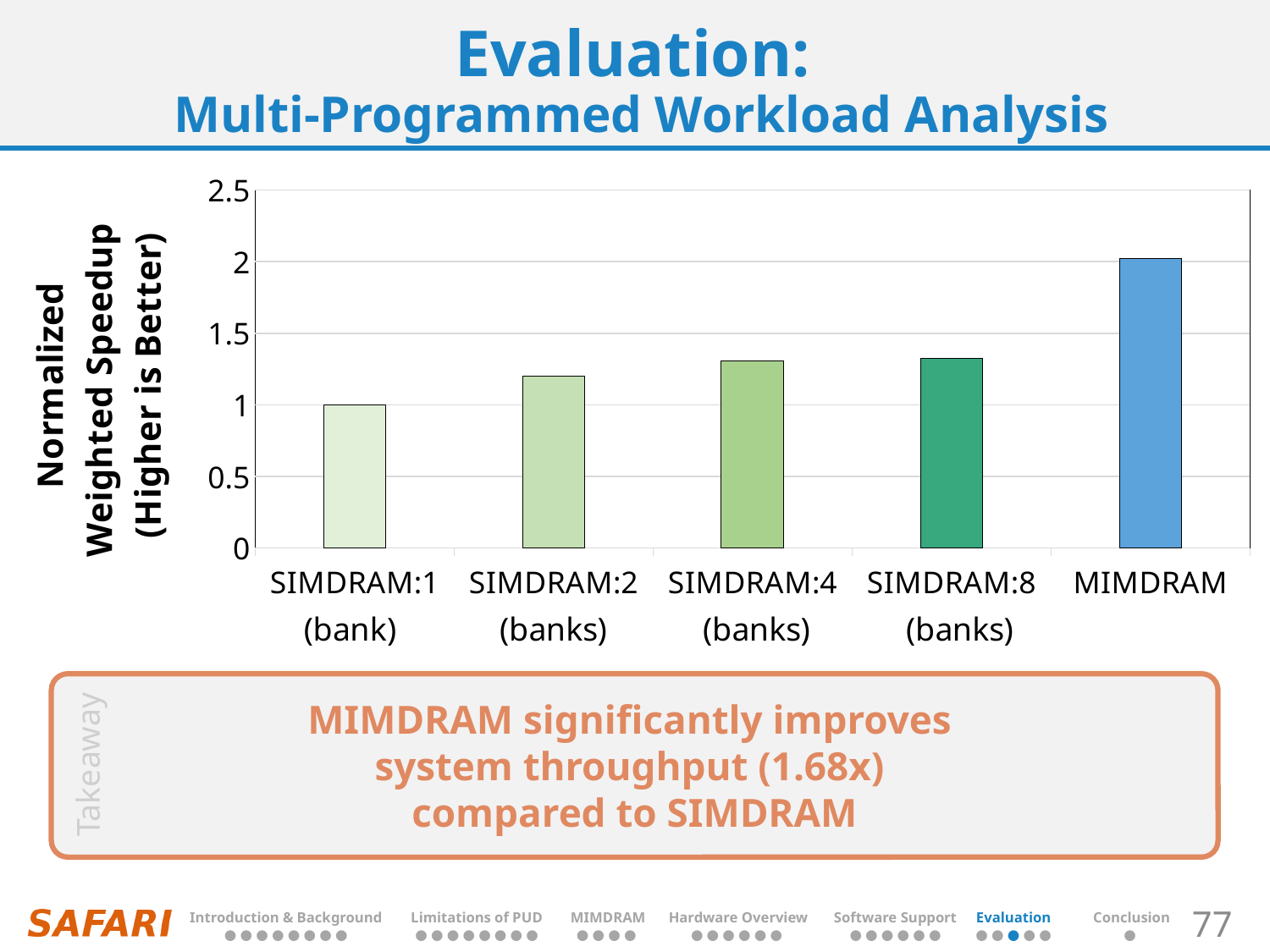
What kind of chart is shown on the slide? bar chart Which is larger, the value for MIMDRAM or the value for SIMDRAM:8 (banks)? MIMDRAM Is the value for SIMDRAM:2 (banks) greater or less than 1.5? less Do the bar values rise or fall from left to right across the x axis? rise What is the label of the y axis? Normalized Weighted Speedup (Higher is Better) Which category has the lowest normalized weighted speedup? SIMDRAM:1 (bank) Is the value for SIMDRAM:8 (banks) greater or less than 1? greater How many bars (categories) are plotted in the chart? 5 Is the value for MIMDRAM greater or less than 1.5? greater Which is larger, the value for SIMDRAM:2 (banks) or the value for SIMDRAM:1 (bank)? SIMDRAM:2 (banks) What is the normalized weighted speedup for SIMDRAM:1 (bank)? 1 Which category has the highest normalized weighted speedup? MIMDRAM